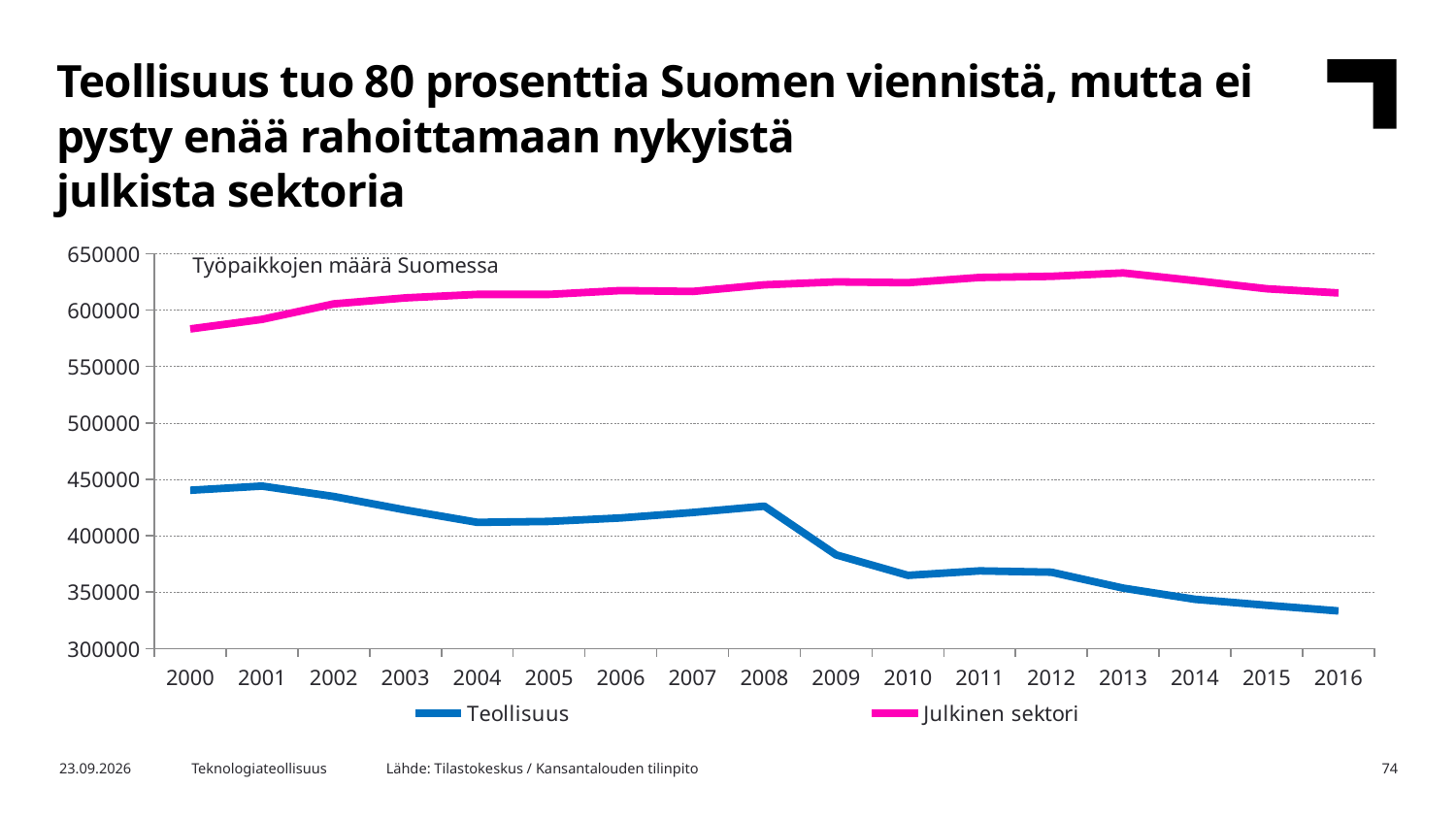
What kind of chart is shown on the slide? line chart Is the Teollisuus value for 2016 greater or less than 350000? less In which year is the Teollisuus value lowest? 2016 Does the Julkinen sektori line rise or fall overall from 2000 to 2016? rises In which year is the Julkinen sektori value highest? 2013 How many series does the legend list? 2 Is the Julkinen sektori value for 2000 greater or less than 600000? less Which series has the higher value in 2016, Teollisuus or Julkinen sektori? Julkinen sektori Is the Teollisuus value for 2000 greater or less than 400000? greater How many years are shown on the x axis? 17 Does the Teollisuus line rise or fall from 2000 to 2016? falls What is the title printed inside the chart area? Työpaikkojen määrä Suomessa